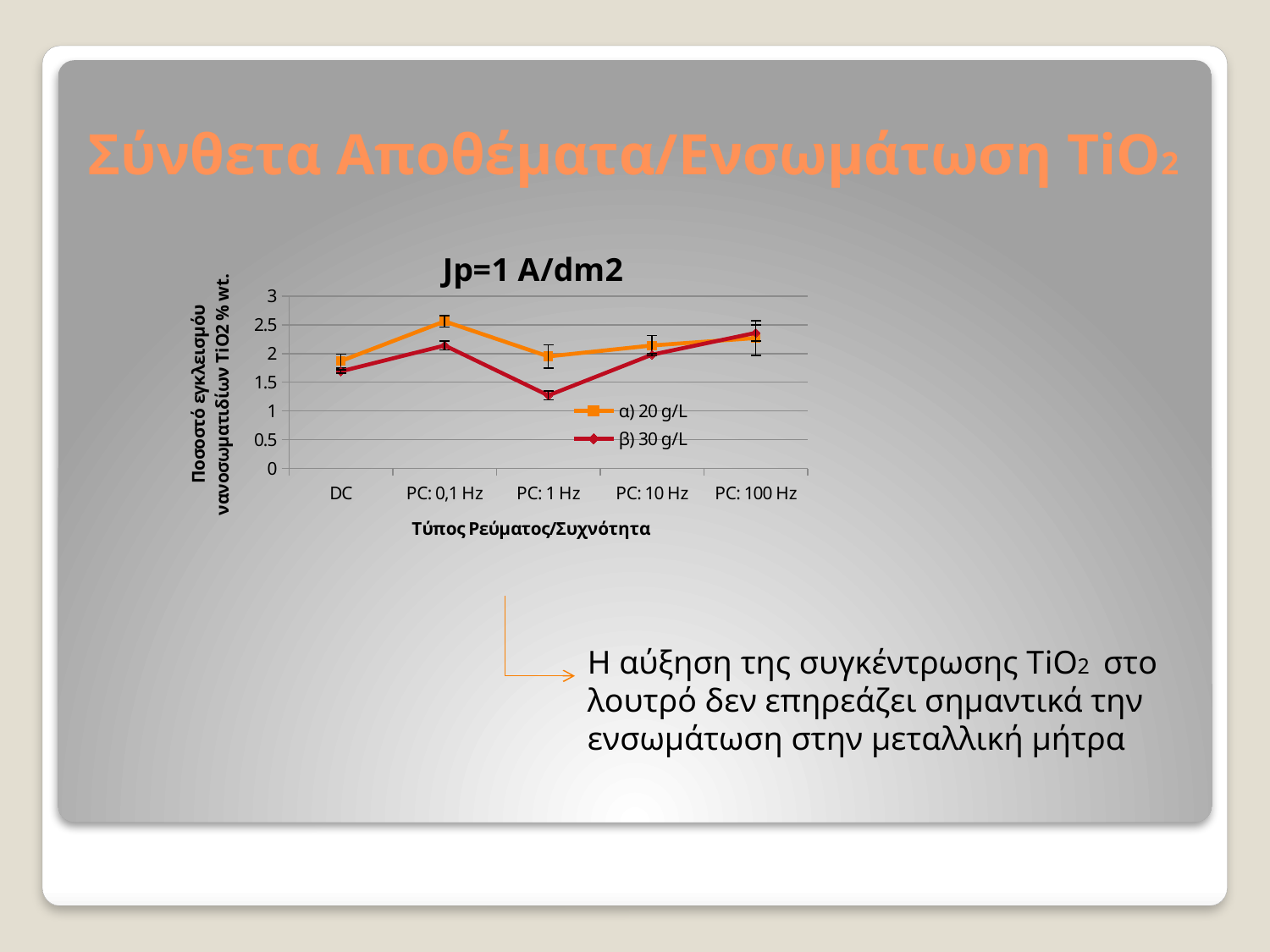
Is the value for β) 30 g/L at DC greater or less than 2? less For the series β) 30 g/L, does the value rise or fall from PC: 0,1 Hz to PC: 1 Hz? fall What is the title of the chart? Jp=1 A/dm2 For the series β) 30 g/L, which category has the lowest value? PC: 1 Hz How many series does the chart's legend list? 2 For the series α) 20 g/L, which category has the highest value? PC: 0,1 Hz Is the value for β) 30 g/L at PC: 1 Hz greater or less than 1.5? less What kind of chart is shown on the slide? line chart How many categories are shown on the x axis of the chart? 5 Which series is drawn in orange in the chart? α) 20 g/L Is the value for α) 20 g/L at PC: 0,1 Hz greater or less than 2? greater At PC: 1 Hz, which series has the larger value, α) 20 g/L or β) 30 g/L? α) 20 g/L